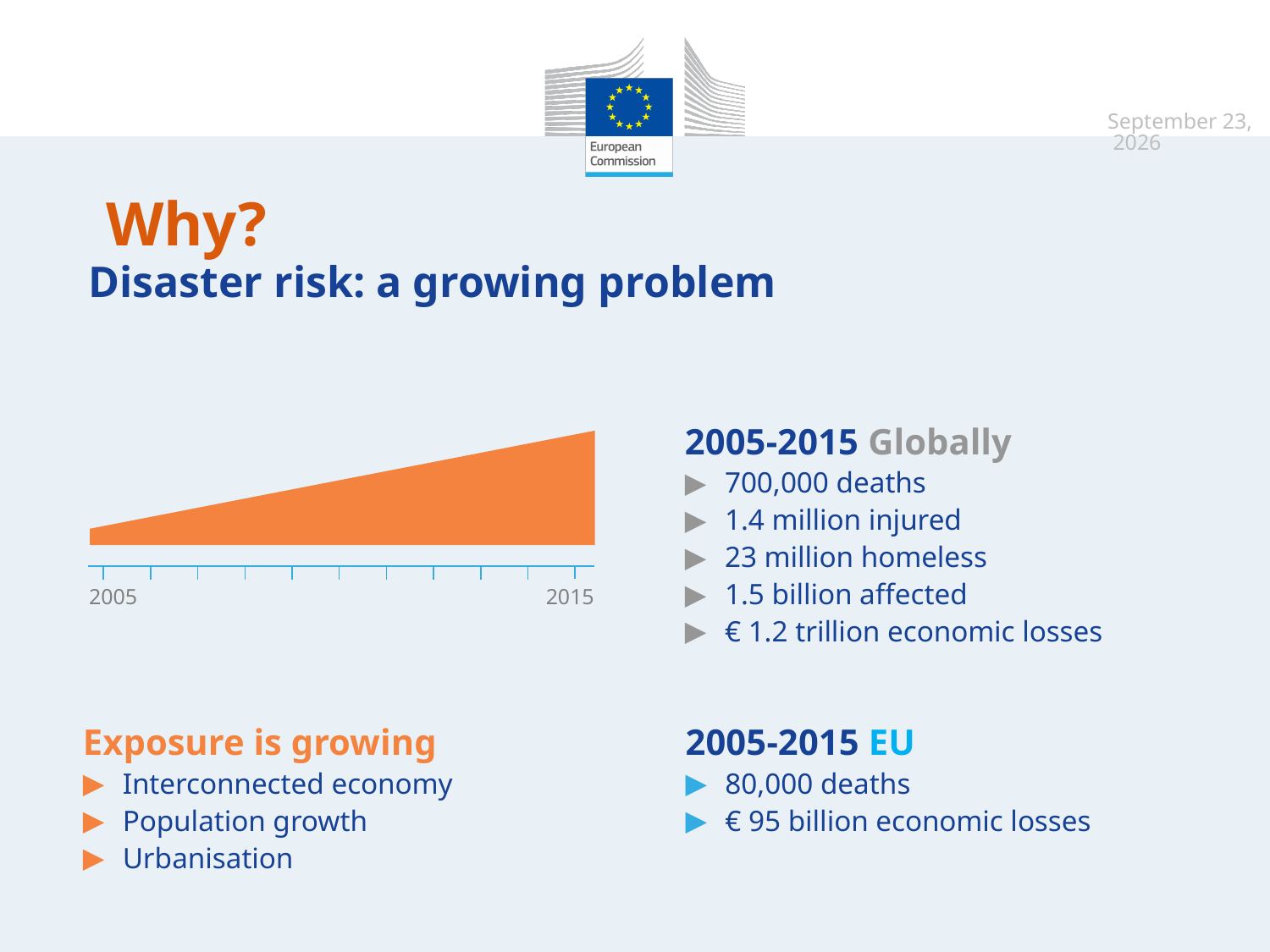
Do the values in the chart rise or fall from 2005 to 2015? rise Which year shown on the chart's x axis has the highest value? 2015 What is the last year labelled on the chart's x axis? 2015 What colour is the filled area in the chart? orange Which year has the larger value in the chart, 2005 or 2015? 2015 Which year shown on the chart's x axis has the lowest value? 2005 What is the first year labelled on the chart's x axis? 2005 What kind of chart is shown on the left of the slide? area chart